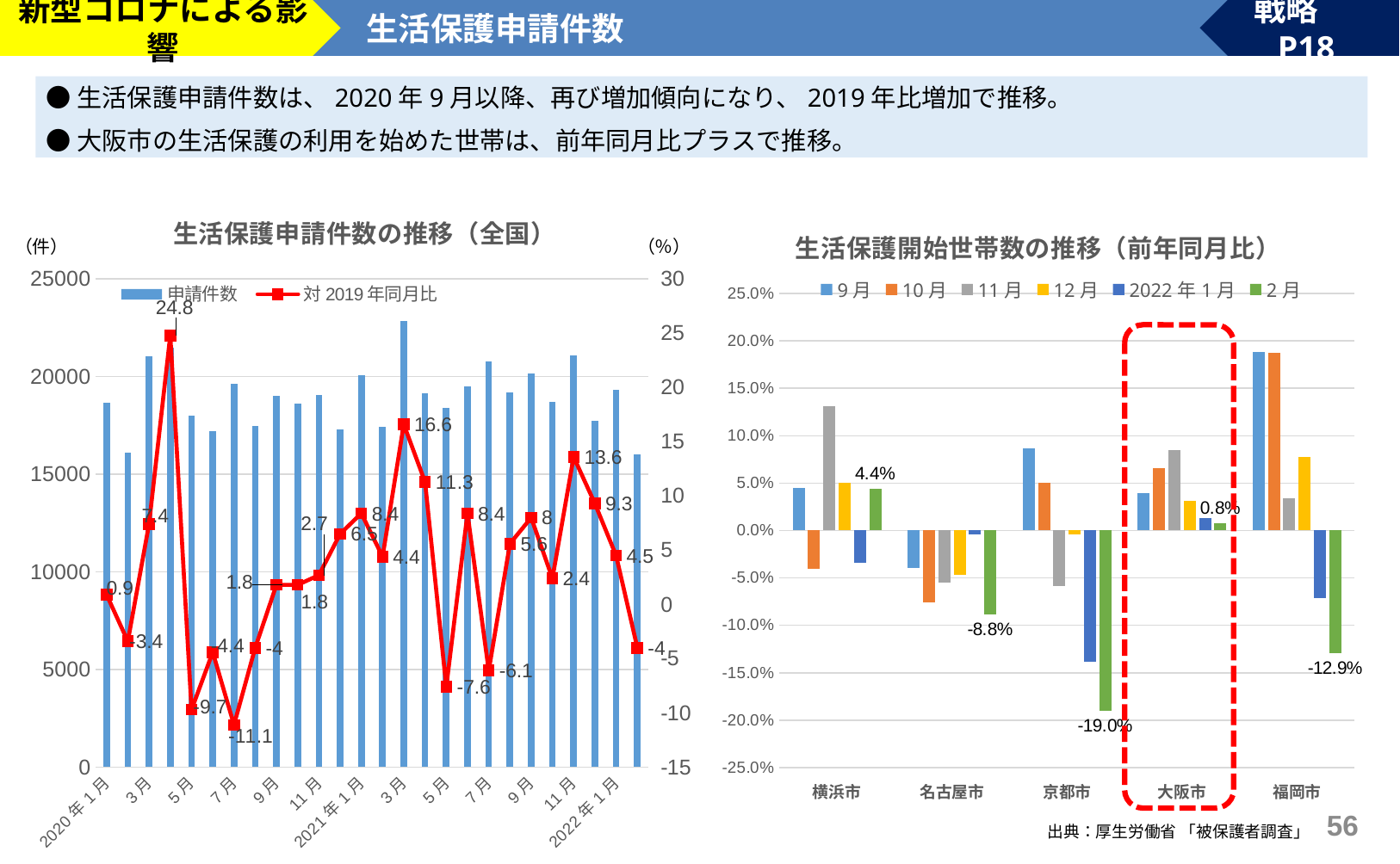
In the right chart 生活保護開始世帯数の推移（前年同月比）, how many cities are shown on the x axis? 5 In the left chart 生活保護申請件数の推移（全国）, what is the highest value of the 対2019年同月比 line? 24.8 In the right chart 生活保護開始世帯数の推移（前年同月比）, is the 9月 value for 福岡市 greater or less than 15.0%? greater In the left chart 生活保護申請件数の推移（全国）, what is the 対2019年同月比 value for 2021年3月? 16.6 In the right chart 生活保護開始世帯数の推移（前年同月比）, which is larger, the 2月 value for 横浜市 or for 大阪市? 横浜市 In the right chart 生活保護開始世帯数の推移（前年同月比）, what is the labelled 2月 value for 京都市? -19.0% In the left chart 生活保護申請件数の推移（全国）, how many series does the legend list? 2 In the left chart 生活保護申請件数の推移（全国）, is the 申請件数 bar for 2021年3月 greater or less than 20000? greater In the right chart 生活保護開始世帯数の推移（前年同月比）, what is the labelled 2月 value for 福岡市? -12.9% In the left chart 生活保護申請件数の推移（全国）, what is the lowest value of the 対2019年同月比 line? -11.1 In the right chart 生活保護開始世帯数の推移（前年同月比）, how many series does the legend list? 6 What kind of chart is the left chart titled 生活保護申請件数の推移（全国）? A combined bar and line chart